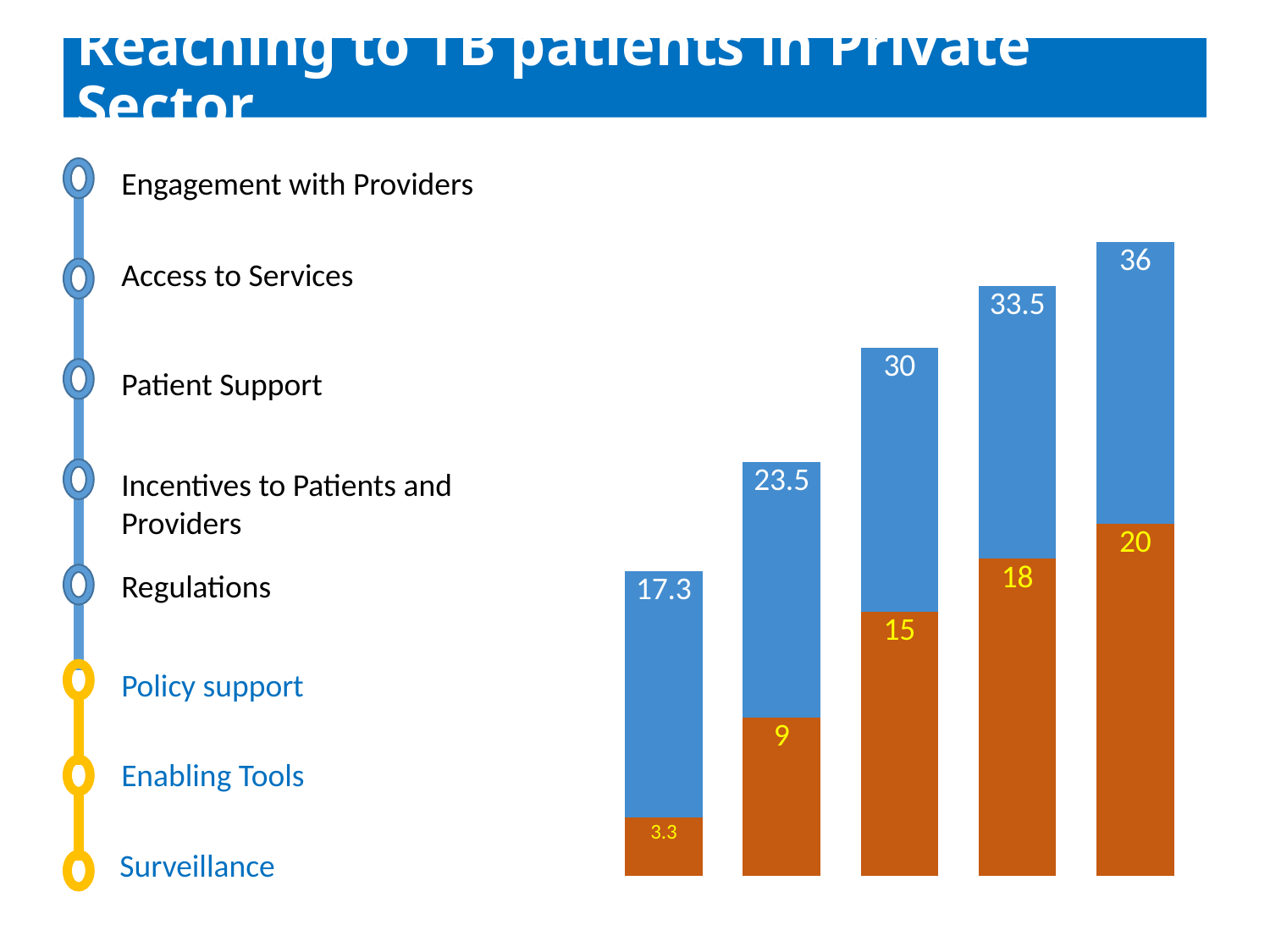
What value is printed at the top of the fifth (rightmost) bar? 36 Which is larger: the orange segment value of the second bar or of the third bar? the third bar (15) What is the difference between the values printed at the top of the fifth bar (36) and the first bar (17.3)? 18.7 How many bars are plotted in the chart? 5 What is the difference between the orange segment values of the fifth bar (20) and the first bar (3.3)? 16.7 Which bar has the smallest value printed on its orange segment? the first (leftmost) bar, 3.3 Do the values printed at the top of the bars rise or fall from left to right? rise What kind of chart is shown on the slide? bar chart What value is printed on the orange segment of the fourth bar from the left? 18 What value is printed at the top of the third bar from the left? 30 Which bar has the largest value printed on its orange segment? the fifth (rightmost) bar, 20 What value is printed on the orange segment of the first (leftmost) bar? 3.3